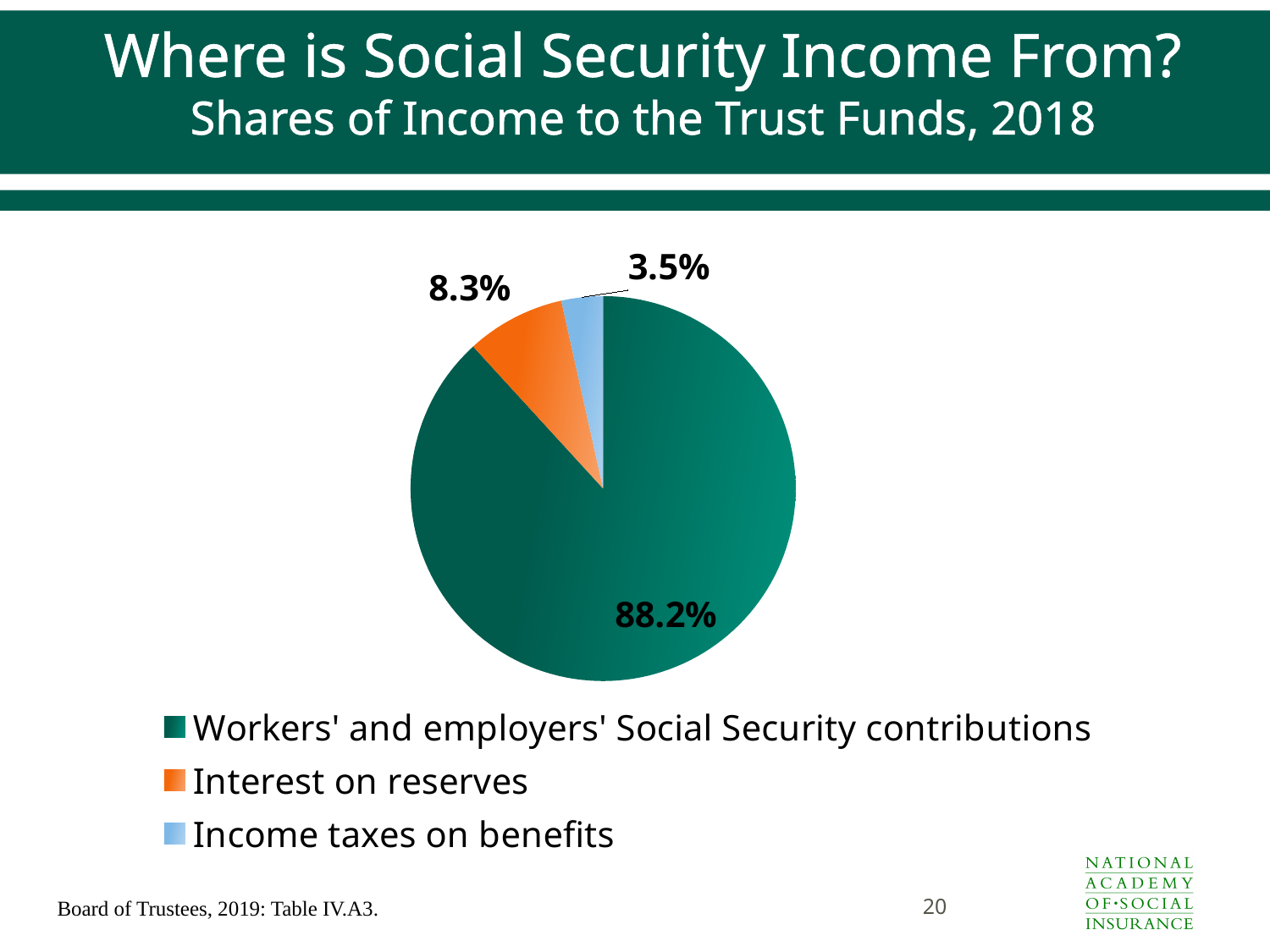
What kind of chart is shown on the slide? Pie chart Which is larger: the share from interest on reserves or the share from income taxes on benefits? Interest on reserves What share of income to the trust funds comes from income taxes on benefits? 3.5% Which source accounts for the smallest share of income to the trust funds? Income taxes on benefits Which source accounts for the largest share of income to the trust funds? Workers' and employers' Social Security contributions What is the difference in percentage points between the share from interest on reserves and the share from income taxes on benefits? 4.8 percentage points What share of income to the trust funds comes from workers' and employers' Social Security contributions? 88.2% What is the difference in percentage points between the share from workers' and employers' Social Security contributions and the share from interest on reserves? 79.9 percentage points What share of income to the trust funds comes from interest on reserves? 8.3% How many entries does the legend list? 3 What colour is the slice representing interest on reserves? Orange How many slices does the pie chart have? 3